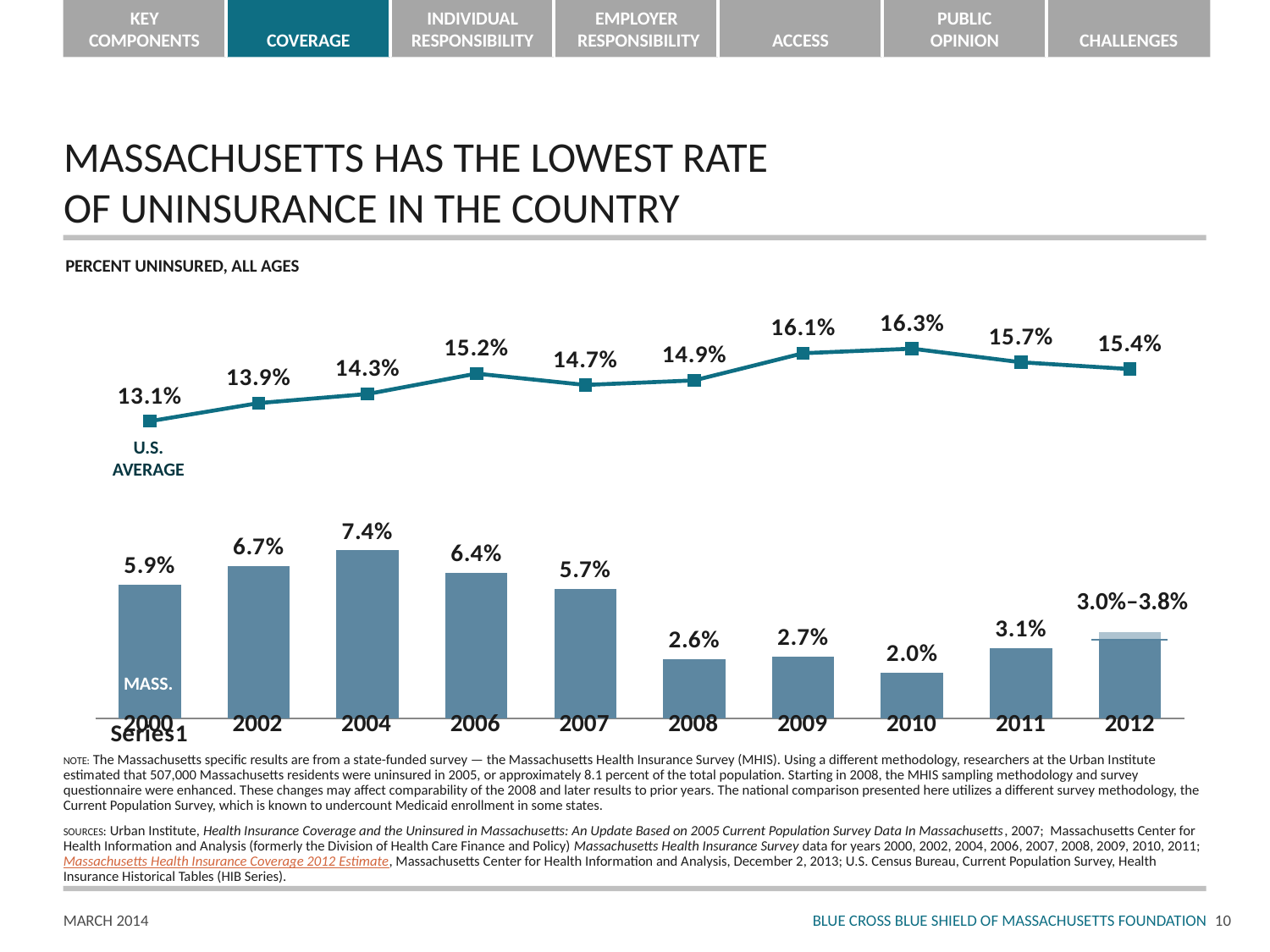
In which year was the U.S. average percent uninsured lowest? 2000 What was the Massachusetts percent uninsured in 2004? 7.4% What is the subtitle printed above the chart? PERCENT UNINSURED, ALL AGES How many years are shown on the x axis of the chart? 10 In which year was the Massachusetts percent uninsured highest? 2004 What was the U.S. average percent uninsured in 2008? 14.9% Which year had a higher Massachusetts uninsured rate, 2006 or 2007? 2006 What value is shown for Massachusetts in 2012? 3.0%–3.8% What kind of chart is used to show the Massachusetts values? Bar chart In which year was the Massachusetts percent uninsured lowest? 2010 What is the difference between the U.S. average and the Massachusetts rate in 2010? 14.3 percentage points What is the difference between the U.S. average and the Massachusetts rate in 2004? 6.9 percentage points